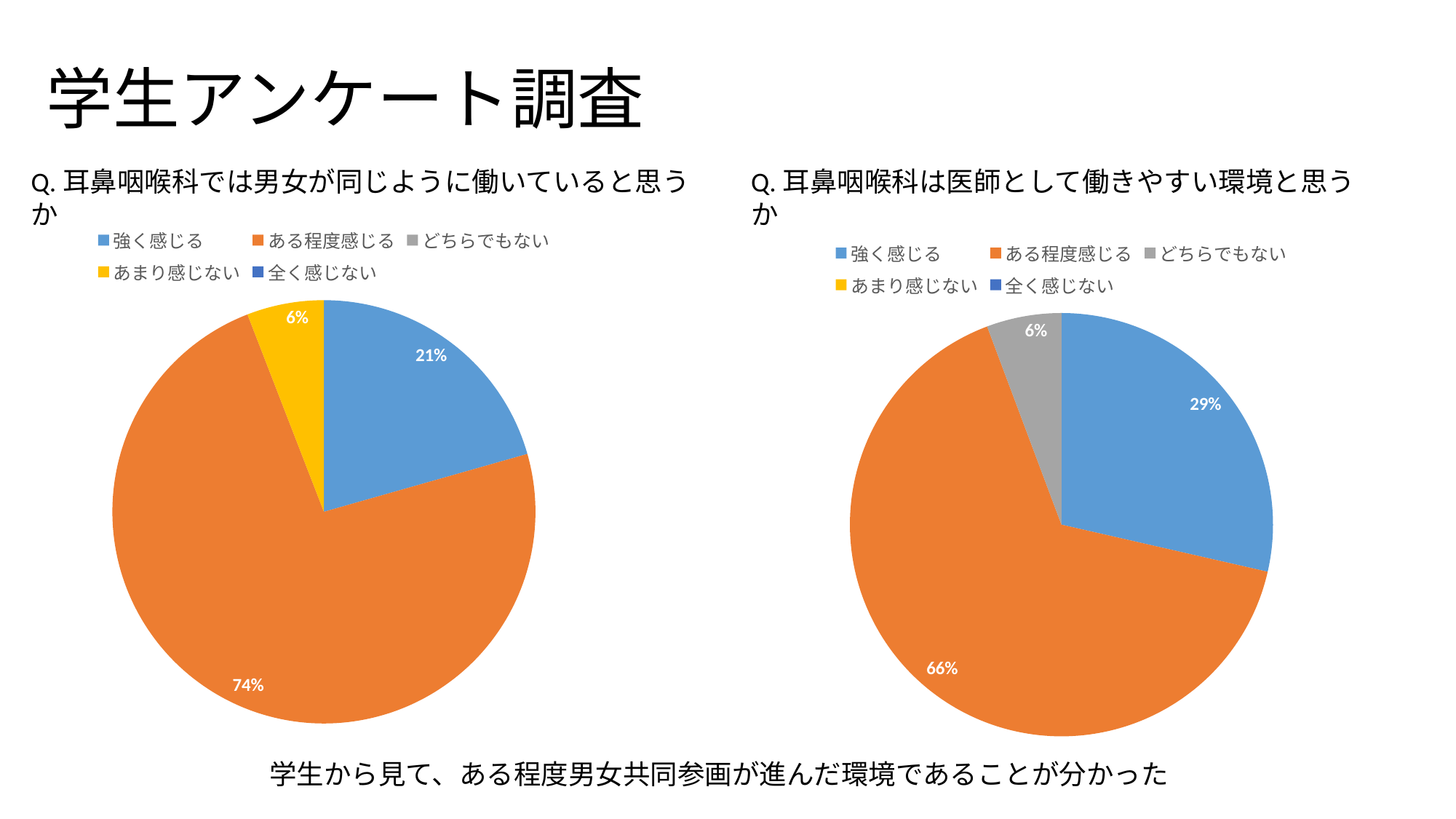
In the right pie chart (耳鼻咽喉科は医師として働きやすい環境と思うか), what percentage is shown for どちらでもない? 6% In the left pie chart (耳鼻咽喉科では男女が同じように働いていると思うか), what percentage is shown for ある程度感じる? 74% How many entries does the legend of the left pie chart (耳鼻咽喉科では男女が同じように働いていると思うか) list? 5 In the left pie chart (耳鼻咽喉科では男女が同じように働いていると思うか), what percentage is shown for あまり感じない? 6% In the right pie chart (耳鼻咽喉科は医師として働きやすい環境と思うか), which category has the largest share? ある程度感じる In the left pie chart (耳鼻咽喉科では男女が同じように働いていると思うか), which category has the largest share? ある程度感じる In the right pie chart (耳鼻咽喉科は医師として働きやすい環境と思うか), which is larger, the share for 強く感じる or the share for どちらでもない? 強く感じる In the right pie chart (耳鼻咽喉科は医師として働きやすい環境と思うか), what percentage is shown for ある程度感じる? 66% What type of chart is used for the right chart (耳鼻咽喉科は医師として働きやすい環境と思うか)? Pie chart In the right pie chart (耳鼻咽喉科は医師として働きやすい環境と思うか), what percentage is shown for 強く感じる? 29% In the left pie chart (耳鼻咽喉科では男女が同じように働いていると思うか), what is the difference between the shares for ある程度感じる and 強く感じる? 53 percentage points In the left pie chart (耳鼻咽喉科では男女が同じように働いていると思うか), what percentage is shown for 強く感じる? 21%